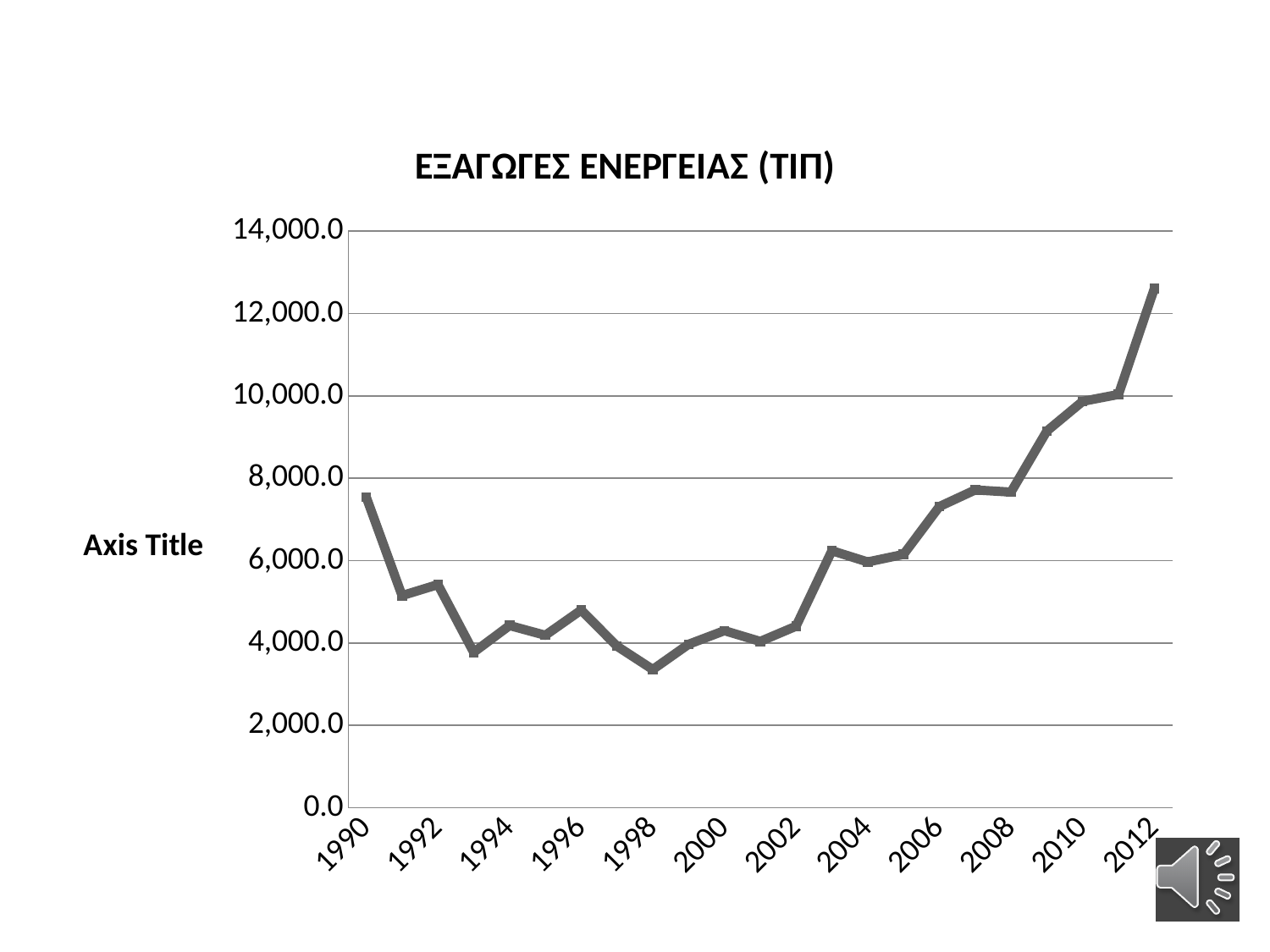
Is the value for 2006 greater or less than 6,000.0? greater Do the values generally rise or fall from 1990 to 1998? fall Which year has the lowest value on the chart? 1998 Which year has the larger value, 1990 or 1992? 1990 What is the title of the chart? ΕΞΑΓΩΓΕΣ ΕΝΕΡΓΕΙΑΣ (ΤΙΠ) Is the value for 2012 greater or less than 12,000.0? greater What kind of chart is shown on the slide? line chart Is the value for 2009 greater or less than 8,000.0? greater Do the values generally rise or fall from 2002 to 2012? rise Which year has the highest value on the chart? 2012